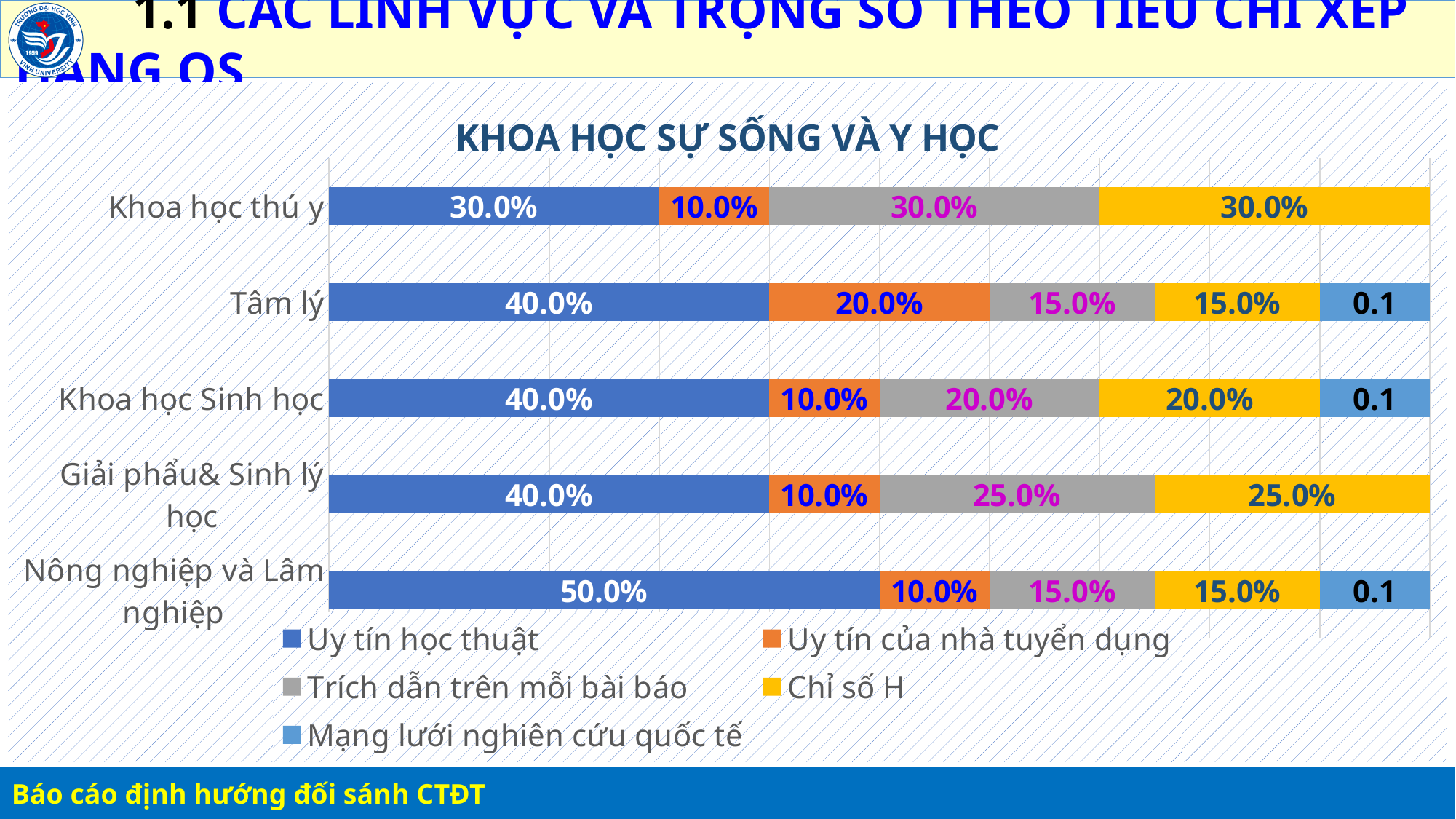
What is the title of the chart? KHOA HỌC SỰ SỐNG VÀ Y HỌC What is the difference between the Uy tín học thuật values for Nông nghiệp và Lâm nghiệp and Khoa học thú y? 20.0% What is the value of Uy tín học thuật for Nông nghiệp và Lâm nghiệp? 50.0% Which category has the lowest value for Uy tín học thuật? Khoa học thú y How many series does the legend list? 5 Which category has the highest value for Uy tín học thuật? Nông nghiệp và Lâm nghiệp How many categories are shown on the chart? 5 What is the value of Uy tín của nhà tuyển dụng for Tâm lý? 20.0% What type of chart is shown on the slide? stacked bar chart What is the value of Trích dẫn trên mỗi bài báo for Khoa học thú y? 30.0% What is the value of Chỉ số H for Giải phẩu& Sinh lý học? 25.0% Which is larger: Chỉ số H for Khoa học Sinh học or Chỉ số H for Tâm lý? Khoa học Sinh học